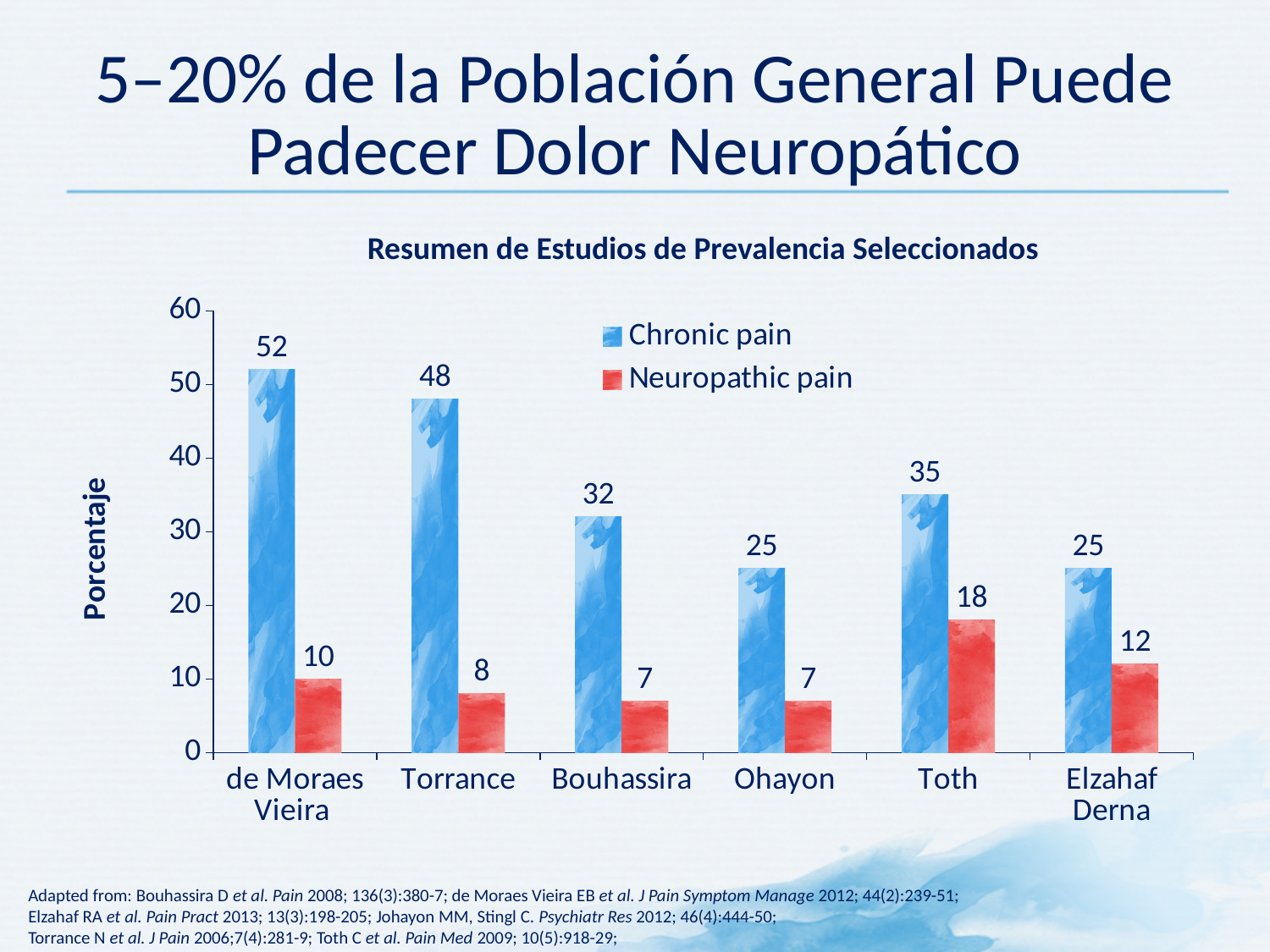
What is the difference between the Chronic pain and Neuropathic pain values for de Moraes Vieira? 42 What is the title of the chart? Resumen de Estudios de Prevalencia Seleccionados What is the difference between the Chronic pain values for Torrance and Bouhassira? 16 What is the Neuropathic pain value for Toth? 18 What is the Chronic pain value for Torrance? 48 Which study has the highest Chronic pain value? de Moraes Vieira Which is larger, the Neuropathic pain value for Toth or for Elzahaf Derna? Toth How many series does the legend list? 2 What is the Neuropathic pain value for Elzahaf Derna? 12 What kind of chart is shown on the slide? Bar chart How many studies are shown on the x axis? 6 Which study has the highest Neuropathic pain value? Toth